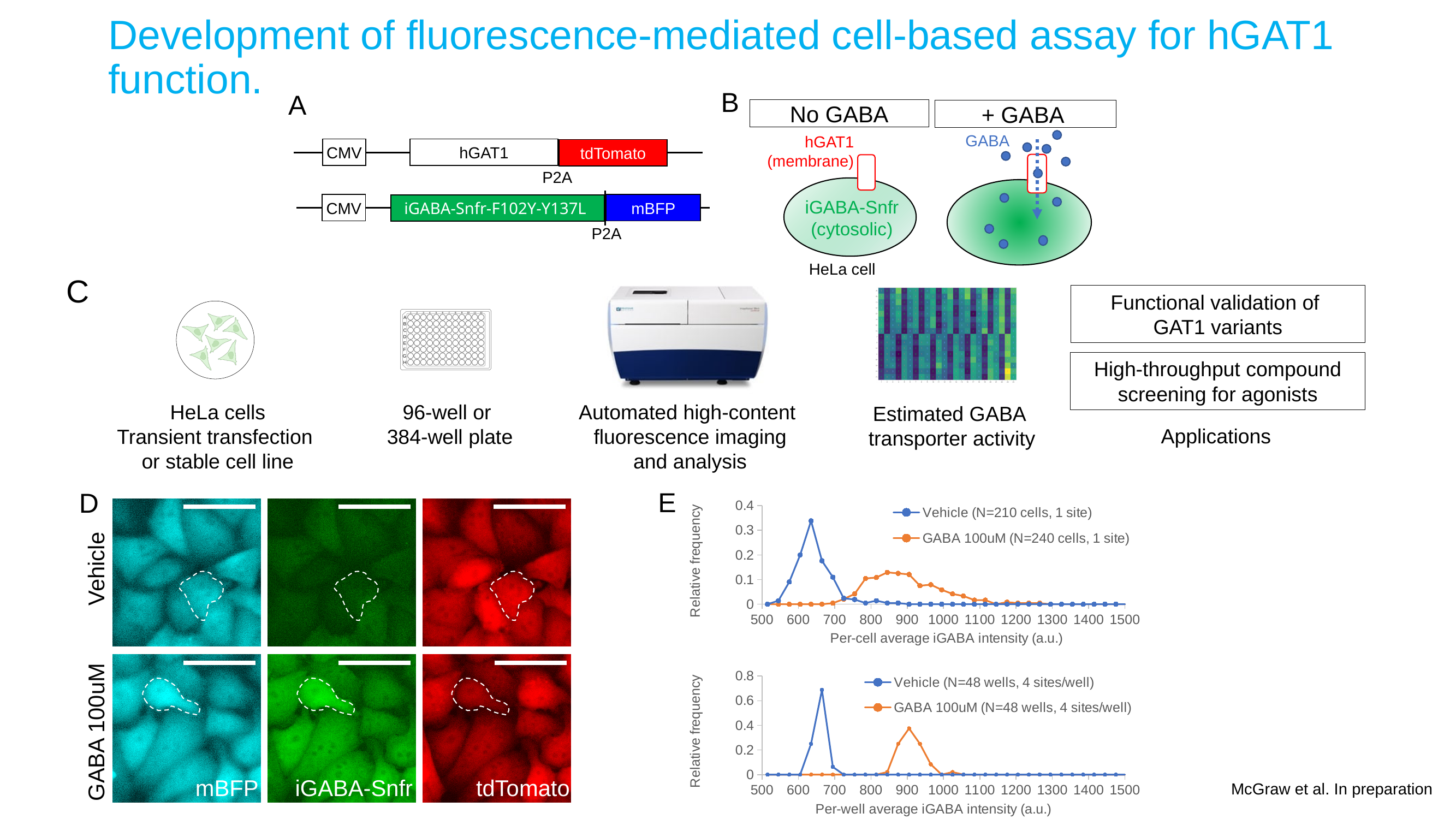
What kind of chart is the top chart in panel E (Per-cell average iGABA intensity)? line chart What is the full legend label of the orange series in the top chart of panel E? GABA 100uM (N=240 cells, 1 site) In the top chart of panel E, is the peak relative frequency of the GABA 100uM series greater or less than 0.2? less How many series does the legend of the top chart in panel E list? 2 How many series does the legend of the bottom chart in panel E list? 2 In the top chart of panel E, which series reaches the higher peak relative frequency, Vehicle or GABA 100uM? Vehicle What is the x-axis label of the bottom chart in panel E? Per-well average iGABA intensity (a.u.) In the bottom chart of panel E, which series reaches the higher peak relative frequency, Vehicle or GABA 100uM? Vehicle In the bottom chart of panel E, is the peak relative frequency of the GABA 100uM series greater or less than 0.2? greater In the top chart of panel E, is the peak relative frequency of the Vehicle series greater or less than 0.3? greater In the top chart of panel E, which series peaks at a higher iGABA intensity on the x axis, Vehicle or GABA 100uM? GABA 100uM